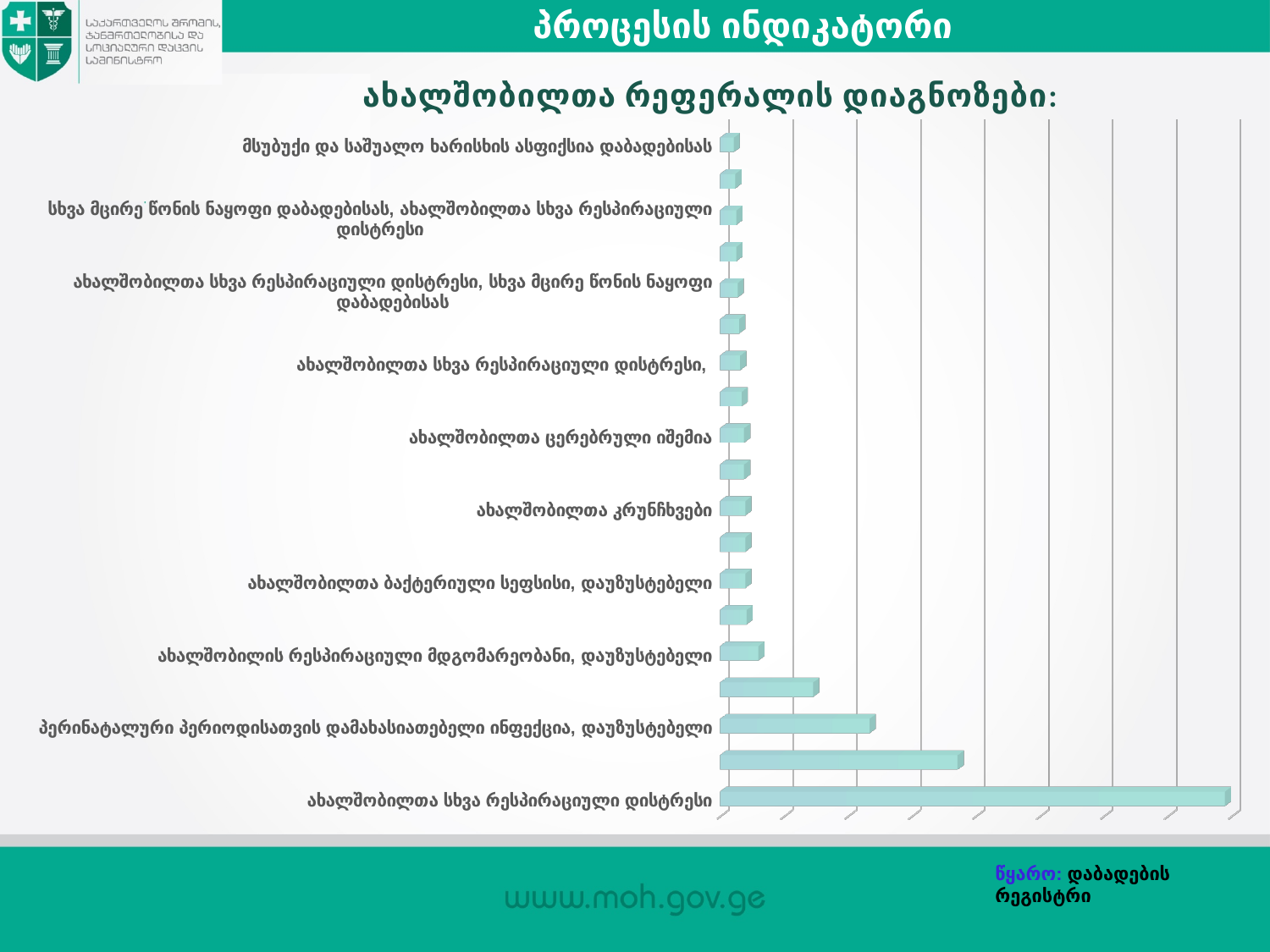
What is the title of the chart? ახალშობილთა რეფერალის დიაგნოზები: Are the bars in the chart oriented horizontally or vertically? horizontally Which bar is longer: "ახალშობილთა სხვა რესპირაციული დისტრესი" (bottom) or "ახალშობილთა კრუნჩხვები"? ახალშობილთა სხვა რესპირაციული დისტრესი Which bar is longer: "ახალშობილთა ბაქტერიული სეფსისი, დაუზუსტებელი" or "პერინატალური პერიოდისათვის დამახასიათებელი ინფექცია, დაუზუსტებელი"? პერინატალური პერიოდისათვის დამახასიათებელი ინფექცია, დაუზუსტებელი Which bar is longer: "პერინატალური პერიოდისათვის დამახასიათებელი ინფექცია, დაუზუსტებელი" or "ახალშობილთა ცერებრული იშემია"? პერინატალური პერიოდისათვის დამახასიათებელი ინფექცია, დაუზუსტებელი What kind of chart is shown on the slide? bar chart Going from the top of the chart to the bottom, do the bars generally get longer or shorter? longer Which category has the longest bar in the chart? ახალშობილთა სხვა რესპირაციული დისტრესი